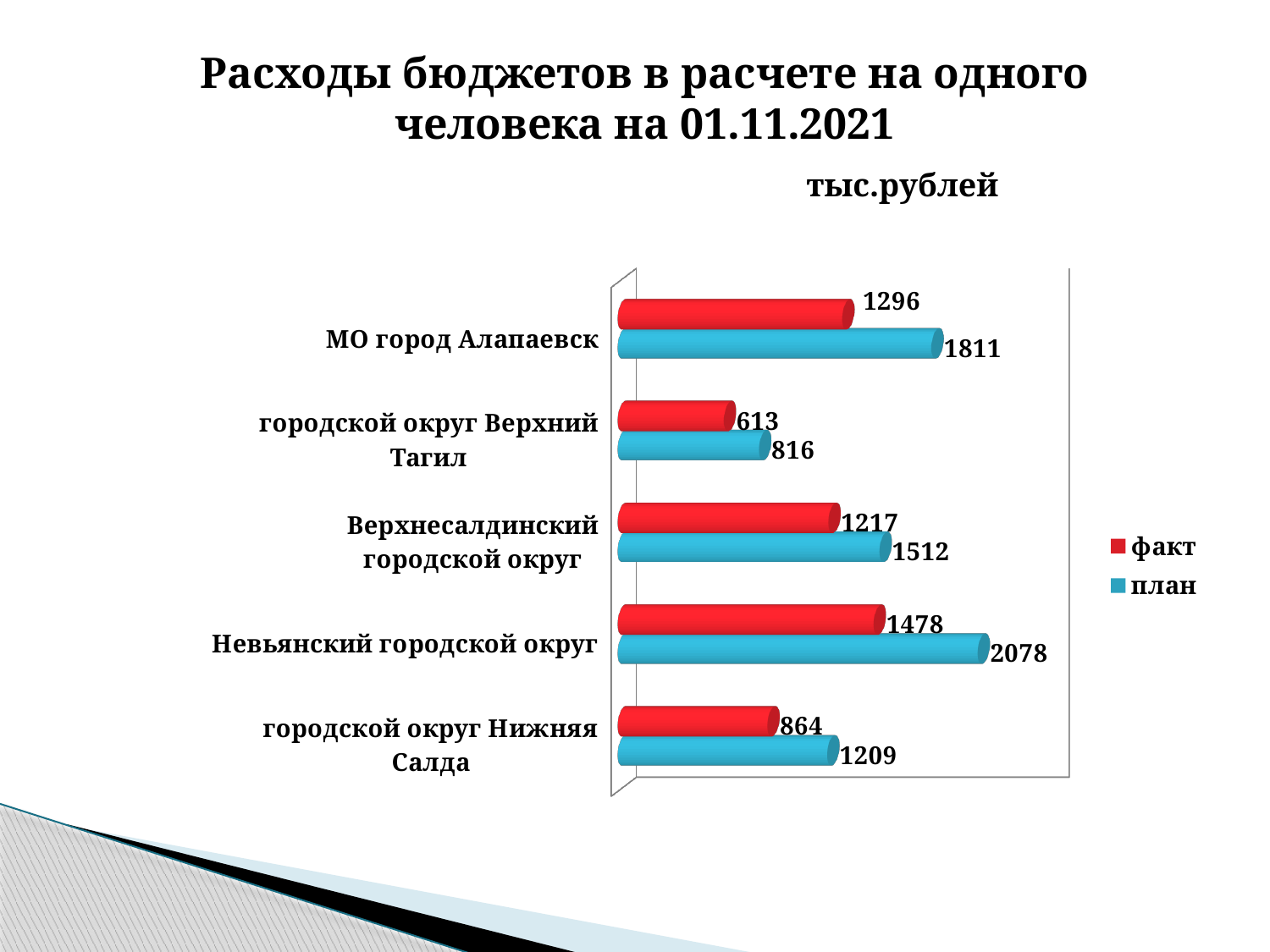
Which is larger: the факт value for Невьянский городской округ or the факт value for МО город Алапаевск? Невьянский городской округ Which category has the lowest факт value? городской округ Верхний Тагил How many series does the legend list? 2 What kind of chart is shown on the slide? bar chart How many categories are shown on the chart? 5 What is the difference between the план and факт values for Верхнесалдинский городской округ? 295 What is the difference between the план and факт values for городской округ Нижняя Салда? 345 What is the факт value for МО город Алапаевск? 1296 What unit is indicated above the chart? тыс.рублей What is the план value for Невьянский городской округ? 2078 What is the план value for городской округ Верхний Тагил? 816 Which category has the highest план value? Невьянский городской округ